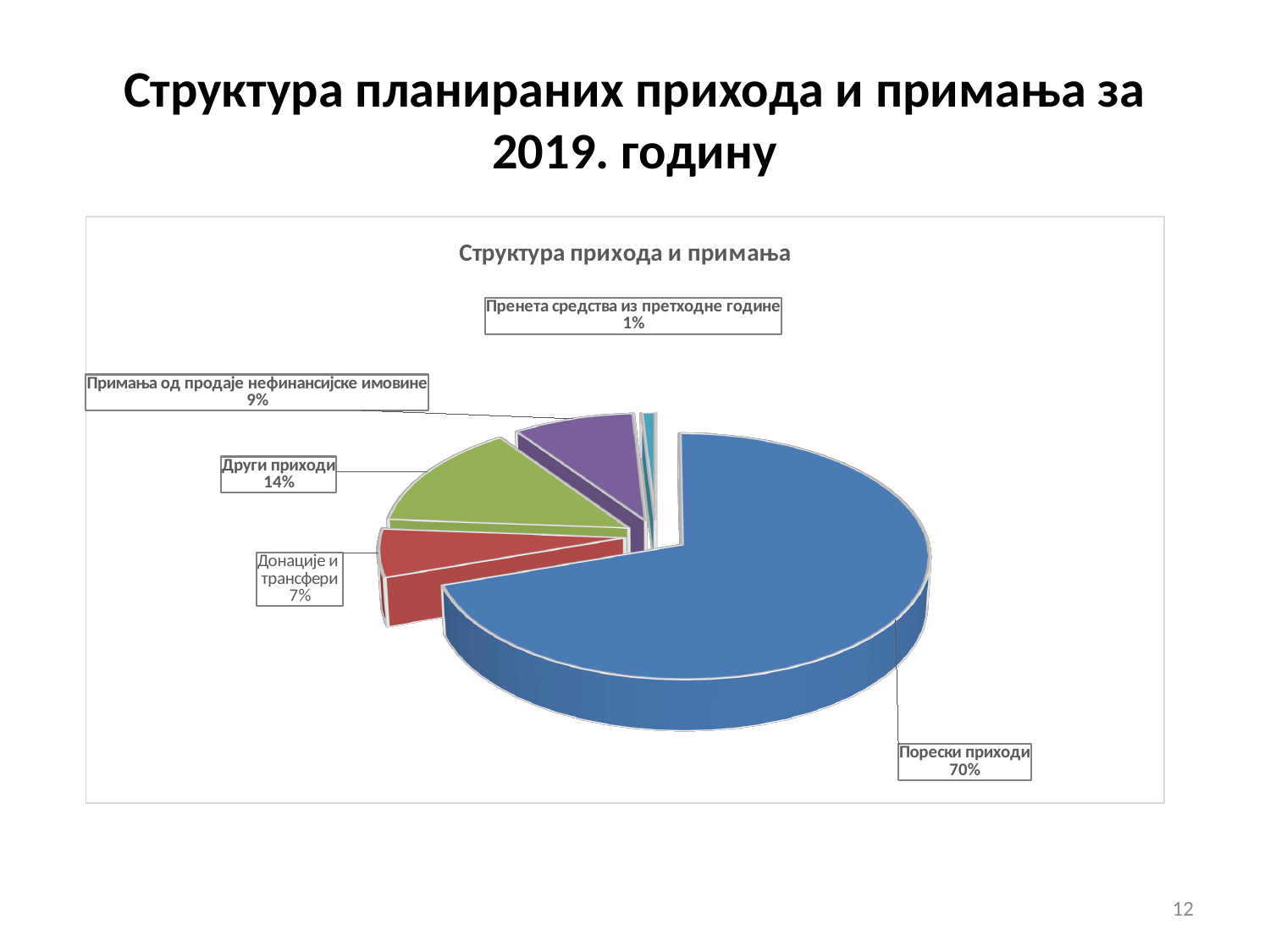
What is the title of the chart? Структура прихода и примања What type of chart is shown on the slide? Pie chart How many slices does the pie chart have? 5 Which category has the smallest slice of the pie? Пренета средства из претходне године Which category has the largest slice of the pie? Порески приходи What share of the pie does Пренета средства из претходне године represent? 1% What share of the pie does Други приходи represent? 14% What share of the pie does Донације и трансфери represent? 7% What is the difference in percentage points between Порески приходи and Други приходи? 56 Which is larger, the share for Донације и трансфери or the share for Примања од продаје нефинансијске имовине? Примања од продаје нефинансијске имовине